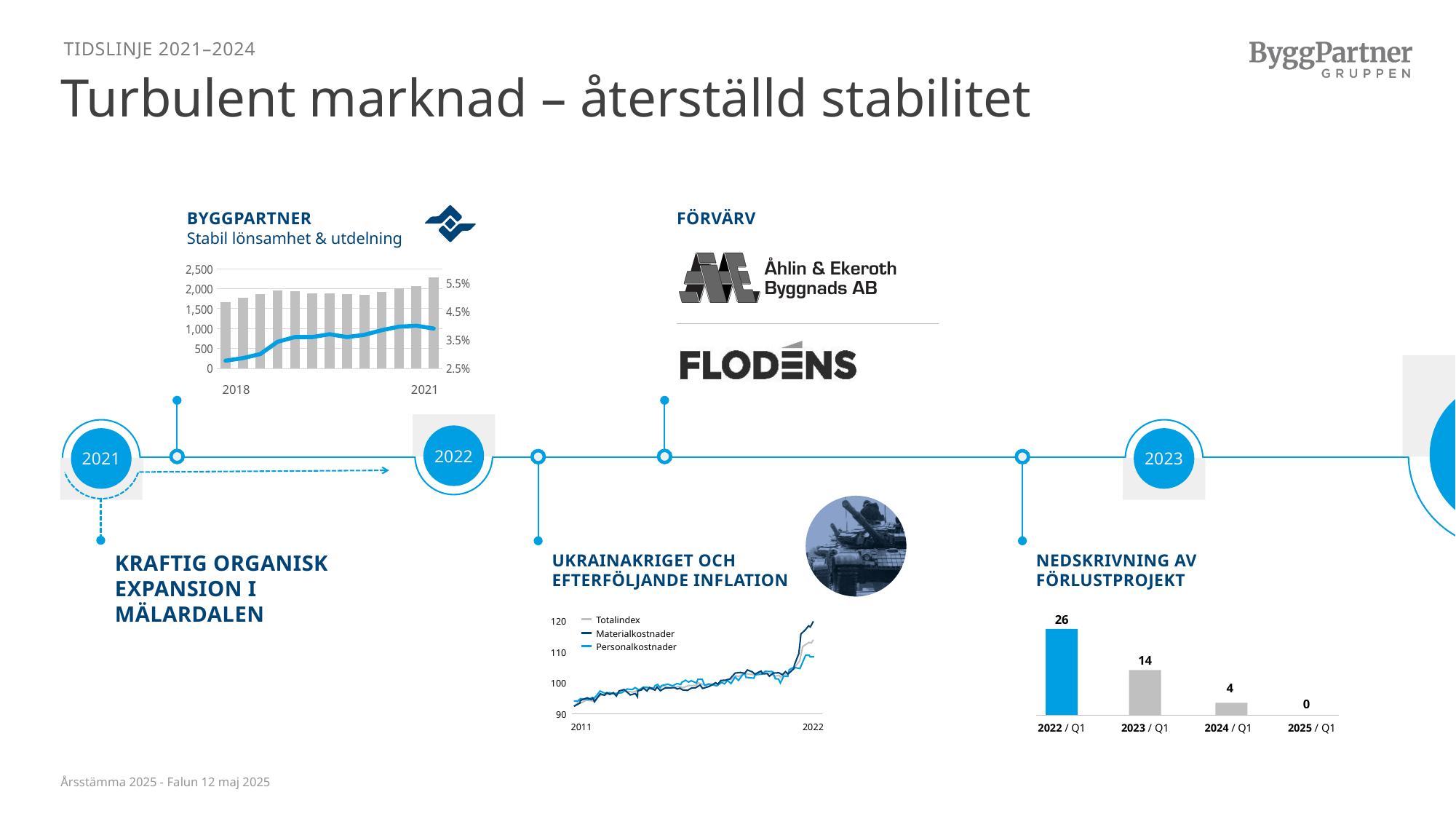
In the 'Nedskrivning av förlustprojekt' chart, what is the difference between the values for 2022 / Q1 and 2023 / Q1? 12 In the 'Ukrainakriget och efterföljande inflation' chart, what are the names of the three series in the legend? Totalindex, Materialkostnader, Personalkostnader In the 'Nedskrivning av förlustprojekt' chart, do the values rise or fall from 2022 / Q1 to 2025 / Q1? fall In the 'Ukrainakriget och efterföljande inflation' chart, how many series does the legend list? 3 In the 'Nedskrivning av förlustprojekt' chart, which period has the highest value? 2022 / Q1 In the 'Ukrainakriget och efterföljande inflation' chart, is the value for Materialkostnader at the end of the series (2022) greater or less than 110? greater In the 'Stabil lönsamhet & utdelning' chart, is the value of the first bar (2018) greater or less than 2,000? less In the 'Nedskrivning av förlustprojekt' chart, which period has the lowest value? 2025 / Q1 In the 'Nedskrivning av förlustprojekt' chart, what is the value for 2022 / Q1? 26 In the 'Nedskrivning av förlustprojekt' chart, how many periods are shown? 4 What kind of chart is the 'Nedskrivning av förlustprojekt' chart? bar chart In the 'Nedskrivning av förlustprojekt' chart, what is the value for 2024 / Q1? 4